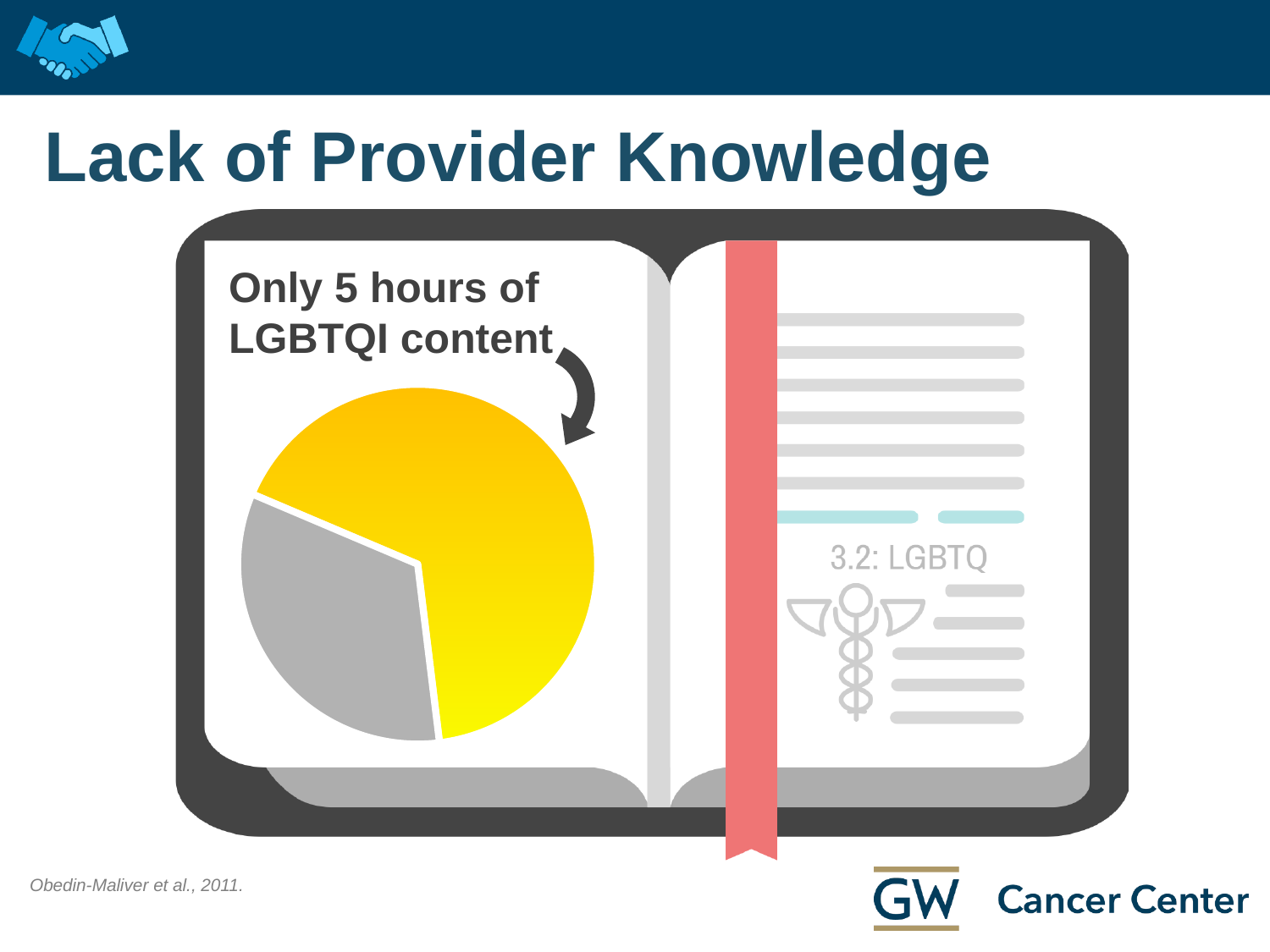
Is the gray slice's share of the pie greater or less than 50%? less Which slice of the pie chart is the largest? the yellow slice Which slice of the pie chart is the smallest? the gray slice How many slices does the pie chart have? 2 What is the title of the slide containing the pie chart? Lack of Provider Knowledge How many hours of LGBTQI content does the annotation next to the pie chart mention? 5 hours What kind of chart is shown on the slide? pie chart Is the yellow slice's share of the pie greater or less than 50%? greater Which slice of the pie chart is larger, the yellow slice or the gray slice? yellow